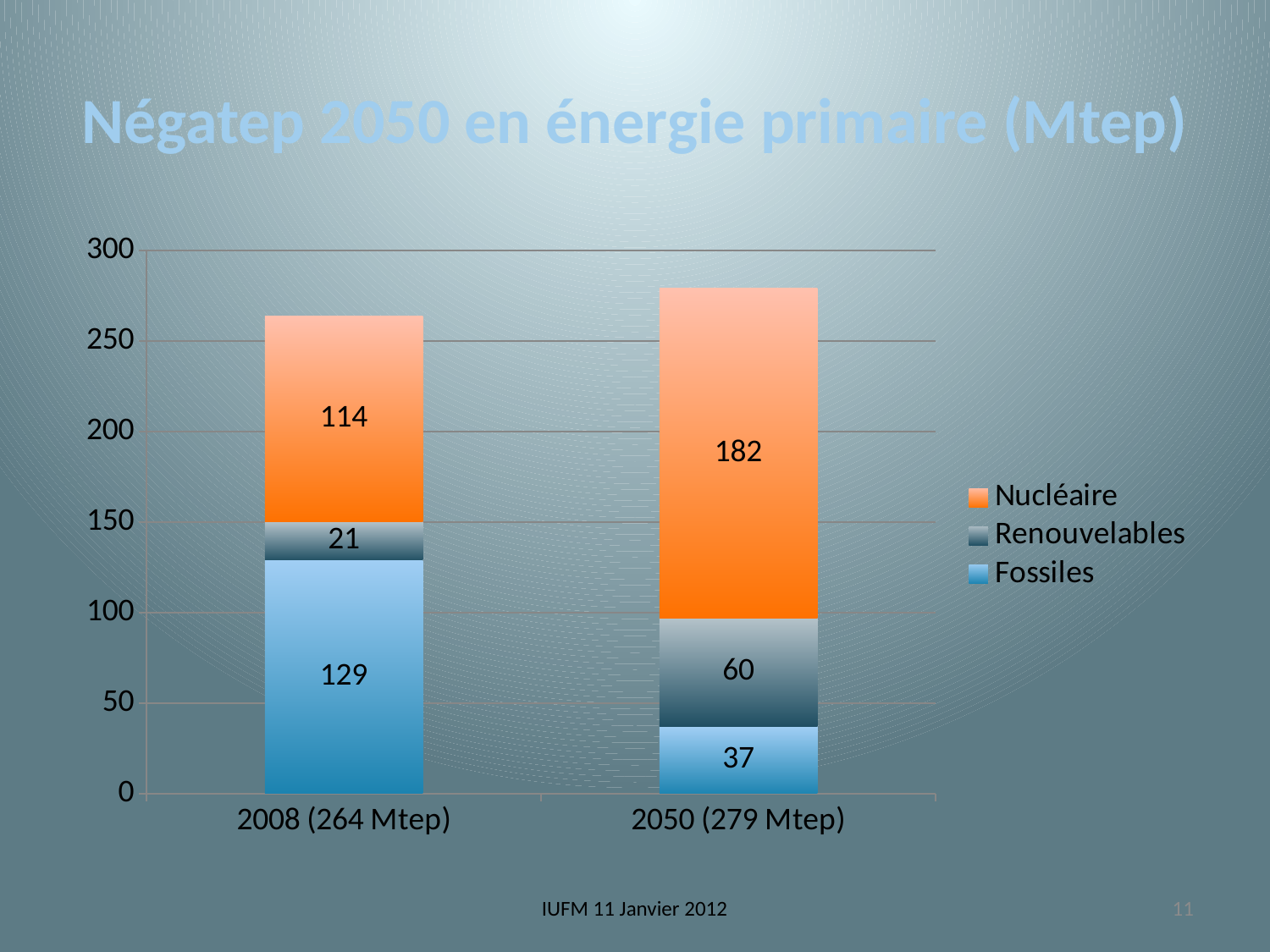
Which category has the highest Renouvelables value? 2050 (279 Mtep) What is the Renouvelables value for 2050 (279 Mtep)? 60 What is the difference between the Nucléaire values for 2050 and 2008? 68 What is the Nucléaire value for 2008 (264 Mtep)? 114 What is the Fossiles value for 2008 (264 Mtep)? 129 Which is larger, the Fossiles value for 2008 or the Fossiles value for 2050? 2008 What is the title of the chart? Négatep 2050 en énergie primaire (Mtep) How many series does the legend list? 3 What is the total of the stacked bar for 2050 (279 Mtep)? 279 What kind of chart is shown on the slide? Stacked bar chart What is the Fossiles value for 2050 (279 Mtep)? 37 What is the total of the stacked bar for 2008 (264 Mtep)? 264